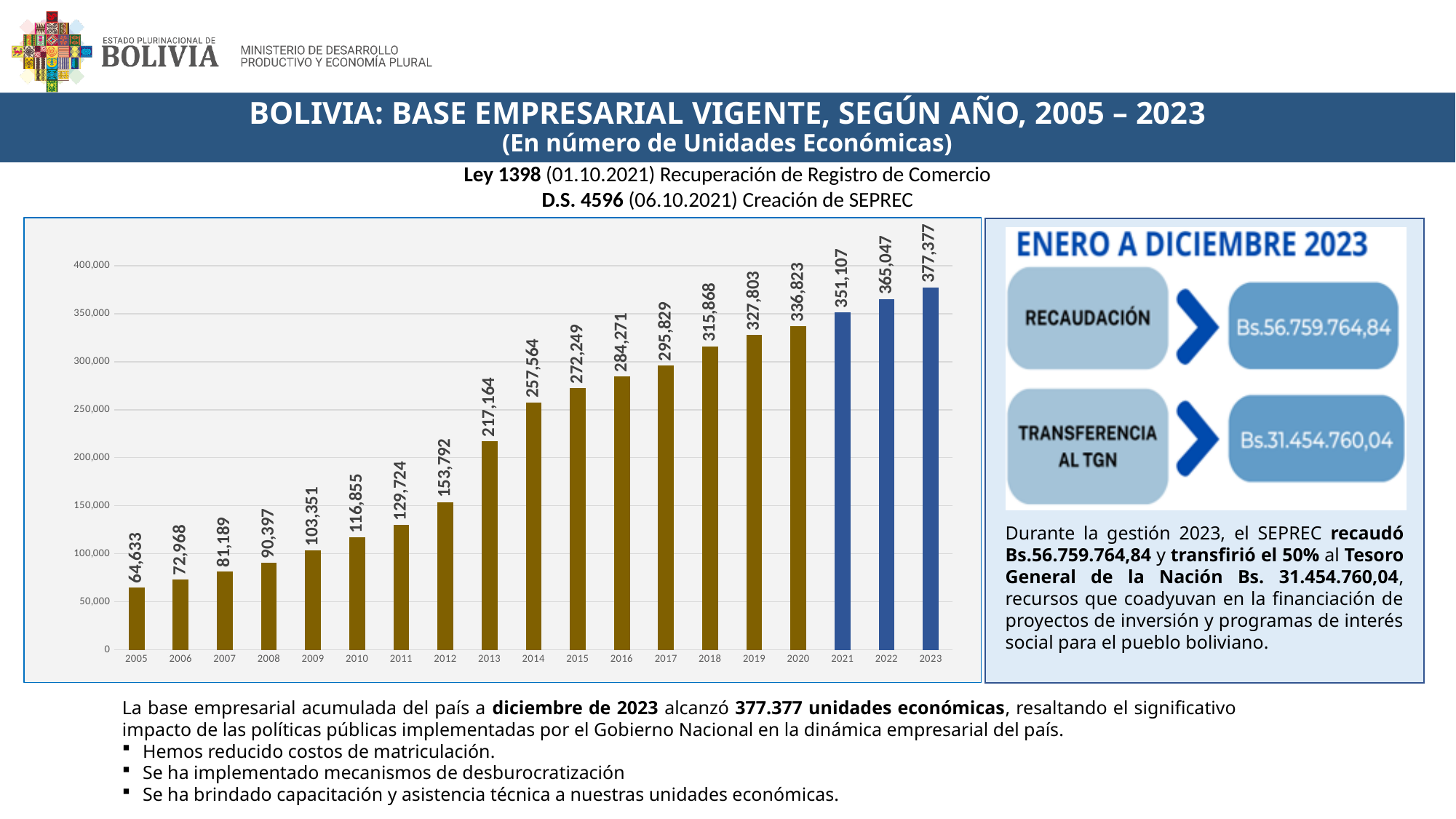
What is the value for 2005? 64,633 What is the difference between the values for 2023 and 2022? 12,330 What is the value for 2023? 377,377 What is the difference between the values for 2013 and 2012? 63,372 Which year has the lowest value? 2005 Which is larger, the value for 2010 or the value for 2016? 2016 What kind of chart is shown? bar chart How many years are shown on the x axis? 19 Which year has the highest value? 2023 Is the value for 2012 greater or less than 150,000? greater What is the value for 2013? 217,164 Do the values rise or fall from 2005 to 2023? rise